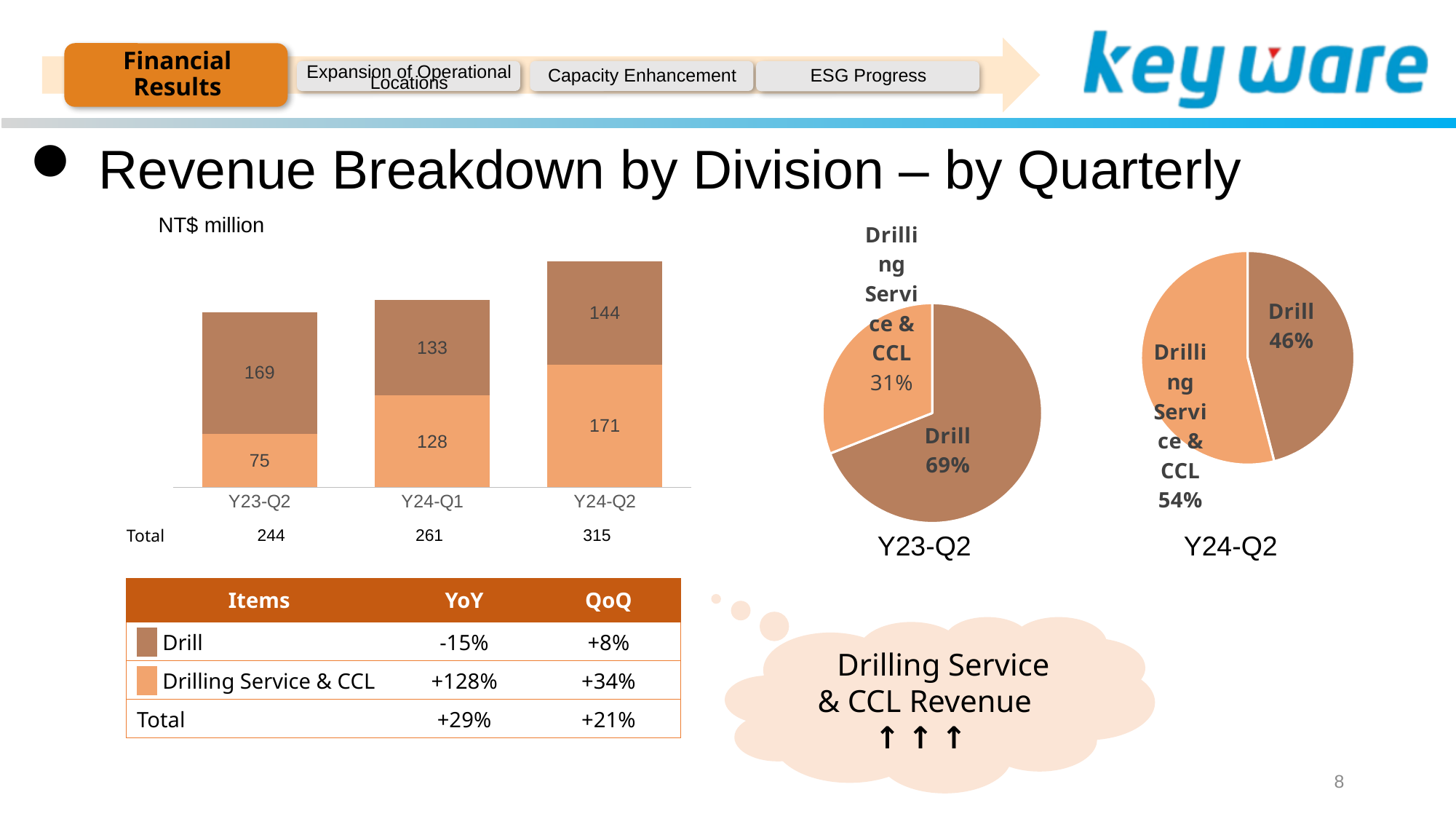
In the stacked bar chart, is the Drill value larger for Y23-Q2 or Y24-Q2? Y23-Q2 In the stacked bar chart, what is the Drilling Service & CCL value for Y24-Q2? 171 In the stacked bar chart, which quarter has the lowest Drilling Service & CCL value? Y23-Q2 In the Y23-Q2 pie chart, what share does Drill have? 69% In the stacked bar chart, what is the Drilling Service & CCL value for Y24-Q1? 128 How many quarters are shown on the x axis of the stacked bar chart? 3 What kind of chart is the chart on the left of the slide? Stacked bar chart In the stacked bar chart, what is the Drill value for Y23-Q2? 169 In the Y24-Q2 pie chart, what share does Drilling Service & CCL have? 54% In the stacked bar chart, what is the difference between the Drilling Service & CCL values for Y24-Q2 and Y23-Q2? 96 In the stacked bar chart, what is the total for the Y24-Q2 bar? 315 In the stacked bar chart, which quarter has the highest total revenue? Y24-Q2